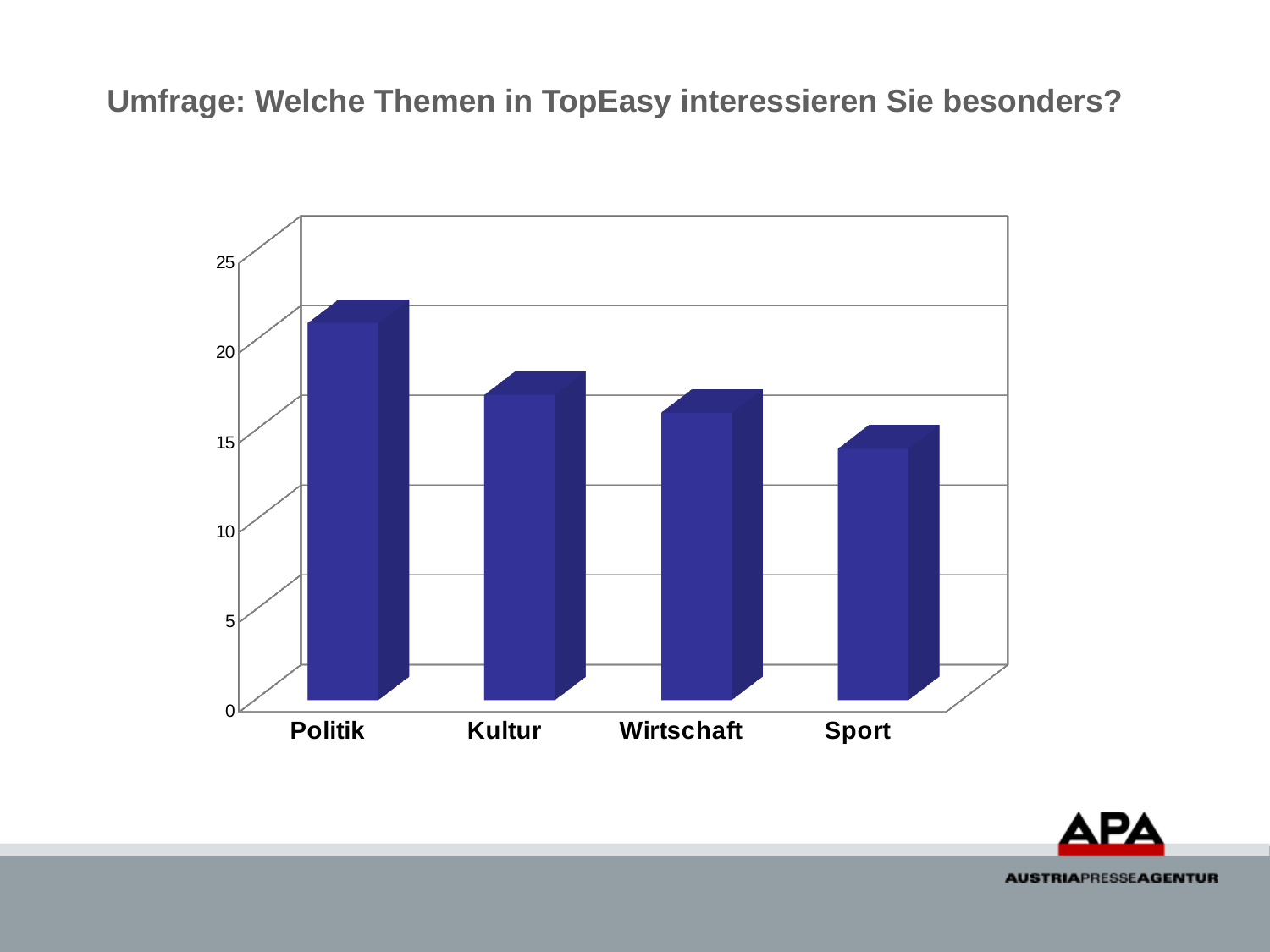
Is the value for Sport greater or less than 10? greater What is the title of the slide containing the chart? Umfrage: Welche Themen in TopEasy interessieren Sie besonders? Is the value for Kultur greater or less than 15? greater What kind of chart is shown on the slide? bar chart Is the value for Sport greater or less than 15? less Which category has the lowest bar in the chart? Sport Do the bar values rise or fall from left to right along the x axis? fall How many categories are shown on the x axis of the chart? 4 Which is larger, the value for Politik or the value for Sport? Politik Which is larger, the value for Kultur or the value for Sport? Kultur Which category has the highest bar in the chart? Politik